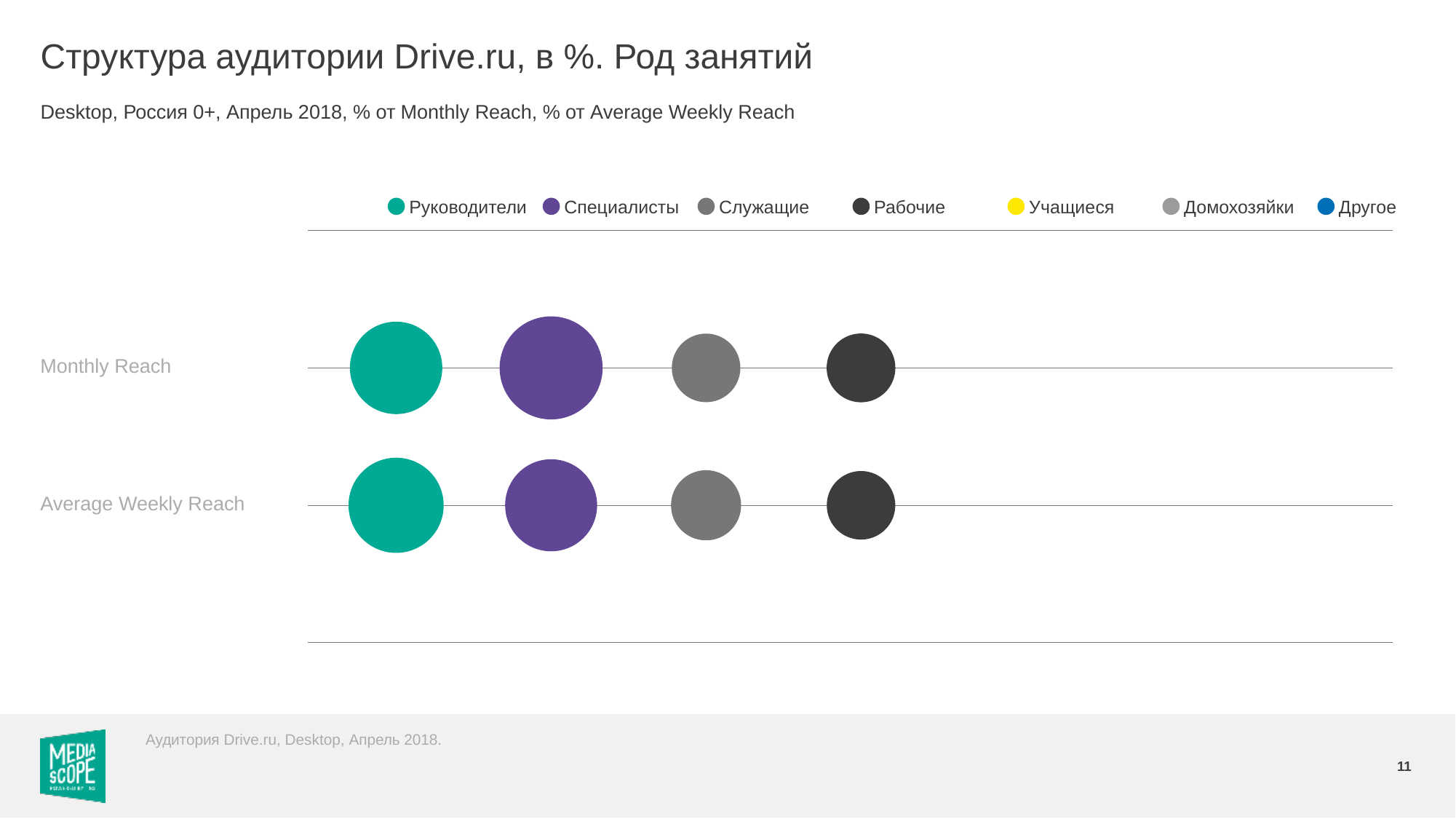
Which legend entry is shown in yellow? Учащиеся How many rows (categories) are plotted on the chart? 2 What kind of chart is shown on the slide? Bubble chart What are the two categories labelled on the left of the chart? Monthly Reach and Average Weekly Reach What is the title of the slide? Структура аудитории Drive.ru, в %. Род занятий In the Monthly Reach row, which is larger: Руководители or Рабочие? Руководители How many series does the legend list? 7 In the Monthly Reach row, which is larger: Специалисты or Служащие? Специалисты In the Monthly Reach row, which occupation group has the largest bubble? Специалисты In the Average Weekly Reach row, which is larger: Руководители or Служащие? Руководители How many visible bubbles are plotted in the Average Weekly Reach row? 4